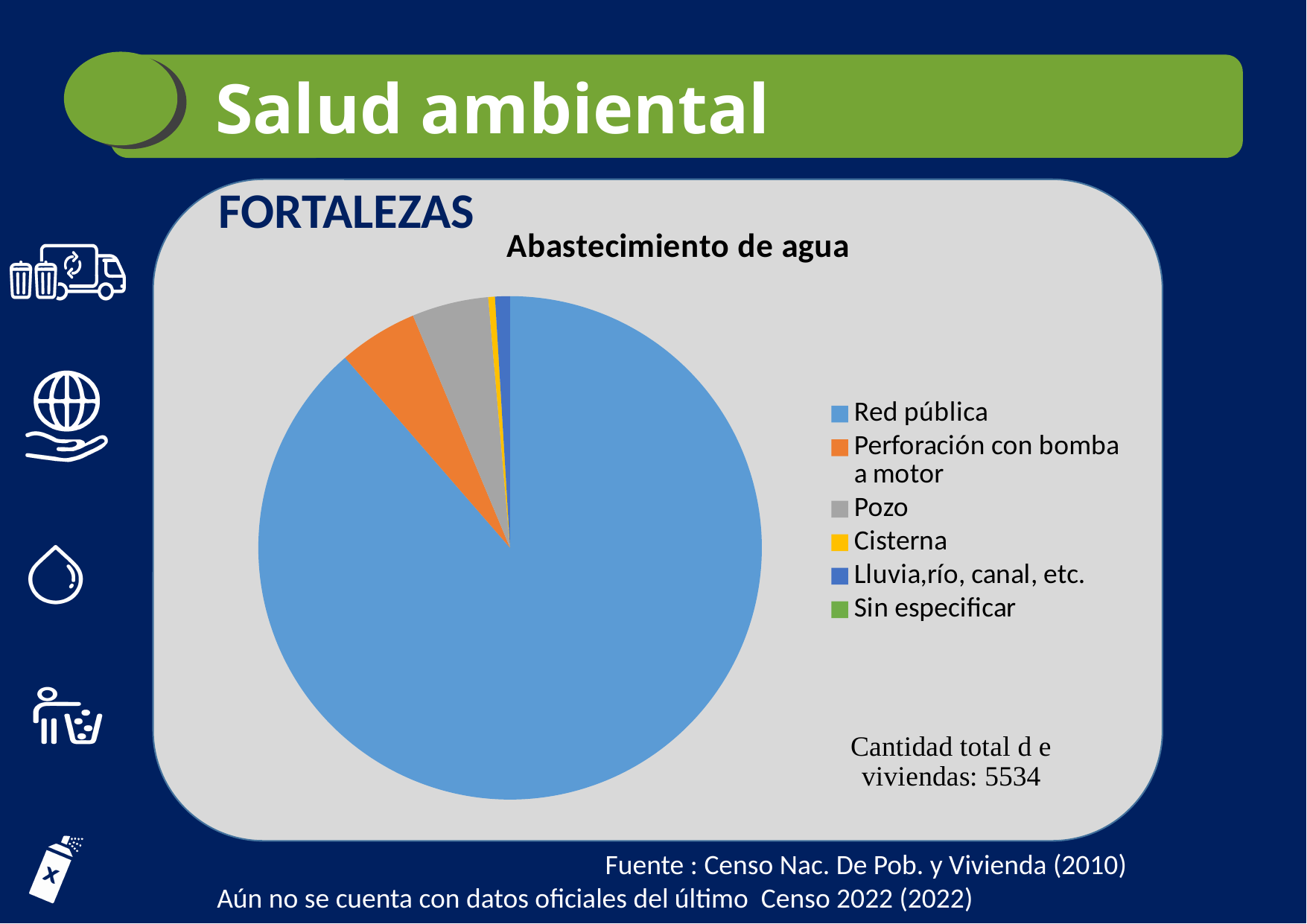
What kind of chart is shown on the slide? pie chart Is the share of Red pública greater or less than half of the pie? greater Which category has the largest slice of the pie chart? Red pública How many categories does the legend of the pie chart list? 6 Which slice is larger, Perforación con bomba a motor or Cisterna? Perforación con bomba a motor What is the title of the pie chart? Abastecimiento de agua Which slice is larger, Red pública or Pozo? Red pública What colour is used for the Red pública slice in the pie chart? blue Which slice is larger, Red pública or Lluvia,río, canal, etc.? Red pública